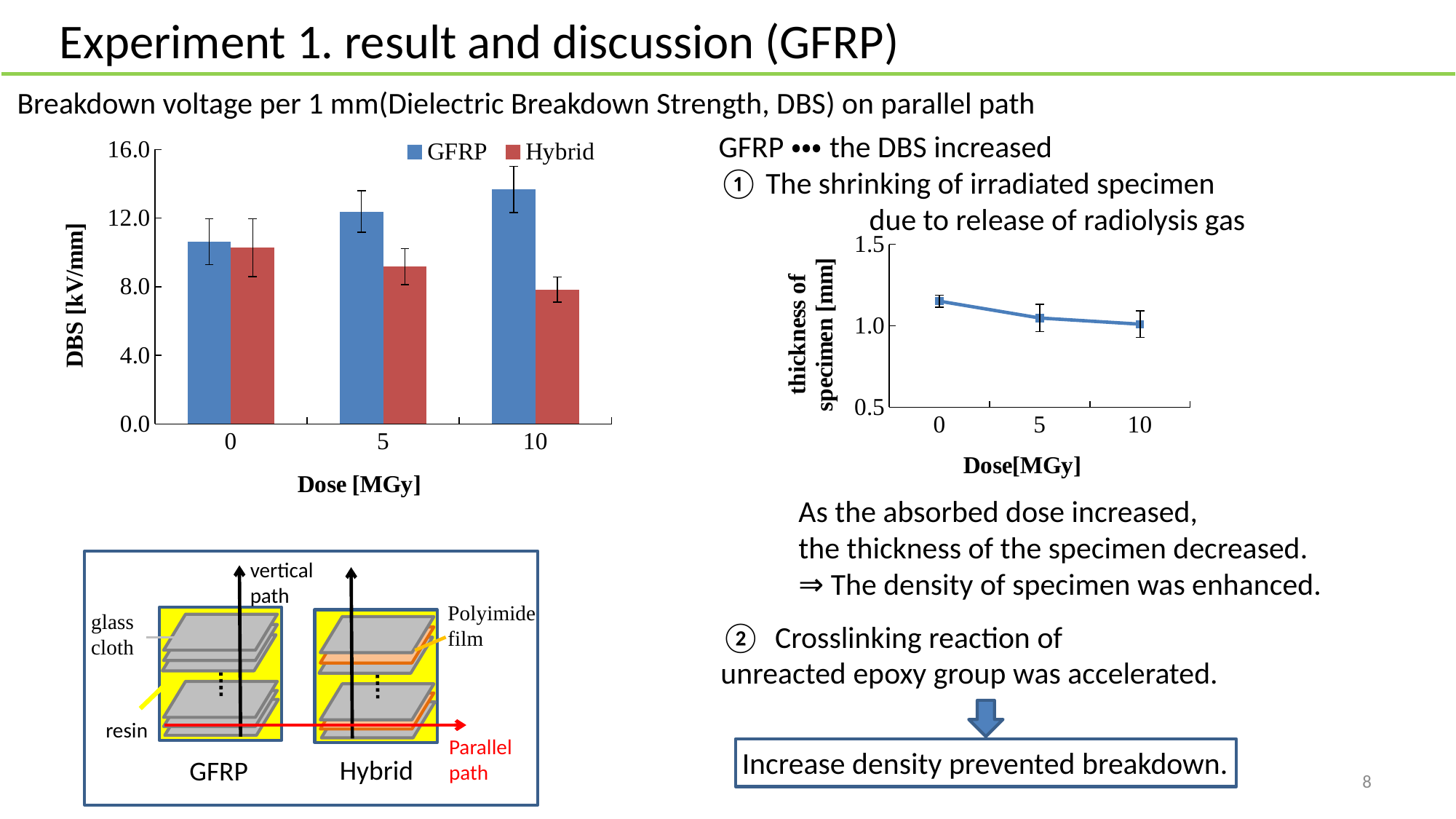
In the DBS bar chart, how many dose categories are shown on the x axis? 3 In the DBS bar chart, what type of chart is shown? bar chart In the DBS bar chart, do the Hybrid values rise or fall as the dose increases? fall In the DBS bar chart, is the Hybrid value at 5 MGy greater or less than 8.0? greater In the DBS bar chart, at which dose is the GFRP value highest? 10 In the DBS bar chart, what is the label of the y axis? DBS [kV/mm] In the DBS bar chart, how many series does the legend list? 2 In the DBS bar chart, is the GFRP value at 10 MGy greater or less than 12.0? greater In the DBS bar chart, at a dose of 10 MGy, which series has the larger value, GFRP or Hybrid? GFRP In the DBS bar chart, at which dose is the Hybrid value lowest? 10 In the thickness of specimen chart, is the thickness at 0 MGy greater or less than 1.0? greater In the thickness of specimen chart, does the thickness rise or fall as the dose increases? fall